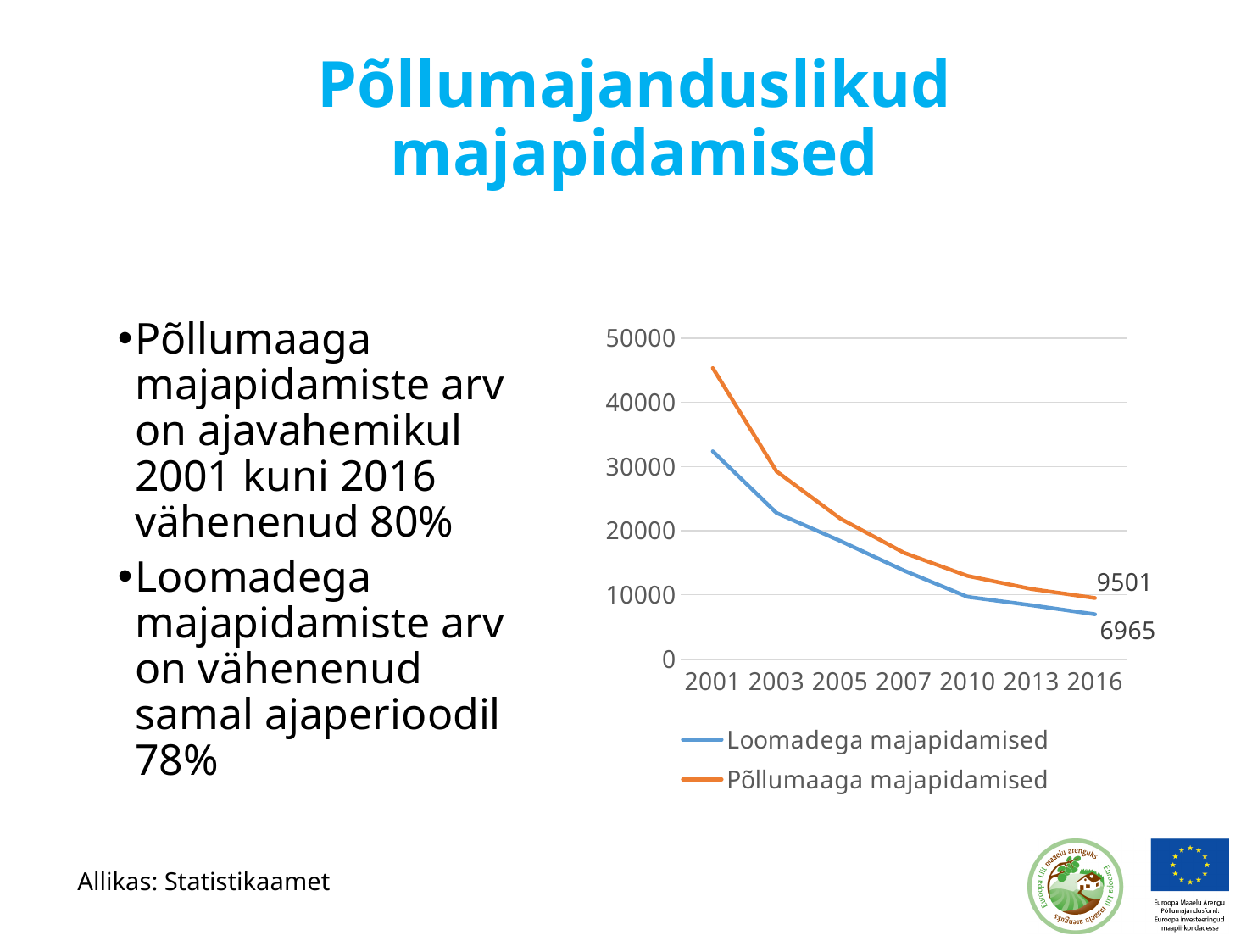
In which year is the value for Põllumaaga majapidamised highest? 2001 What is the value for Põllumaaga majapidamised in 2016? 9501 What is the difference between the 2016 values of Põllumaaga majapidamised and Loomadega majapidamised? 2536 Do the values for Loomadega majapidamised rise or fall from 2001 to 2016? fall What is the value for Loomadega majapidamised in 2016? 6965 What kind of chart is shown on the slide? line chart Is the value for Loomadega majapidamised in 2001 greater or less than 30000? greater In 2016, which series has the larger value: Loomadega majapidamised or Põllumaaga majapidamised? Põllumaaga majapidamised Is the value for Põllumaaga majapidamised in 2001 greater or less than 40000? greater Is the value for Põllumaaga majapidamised in 2007 greater or less than 20000? less How many series does the chart's legend list? 2 How many years are shown on the x axis of the chart? 7